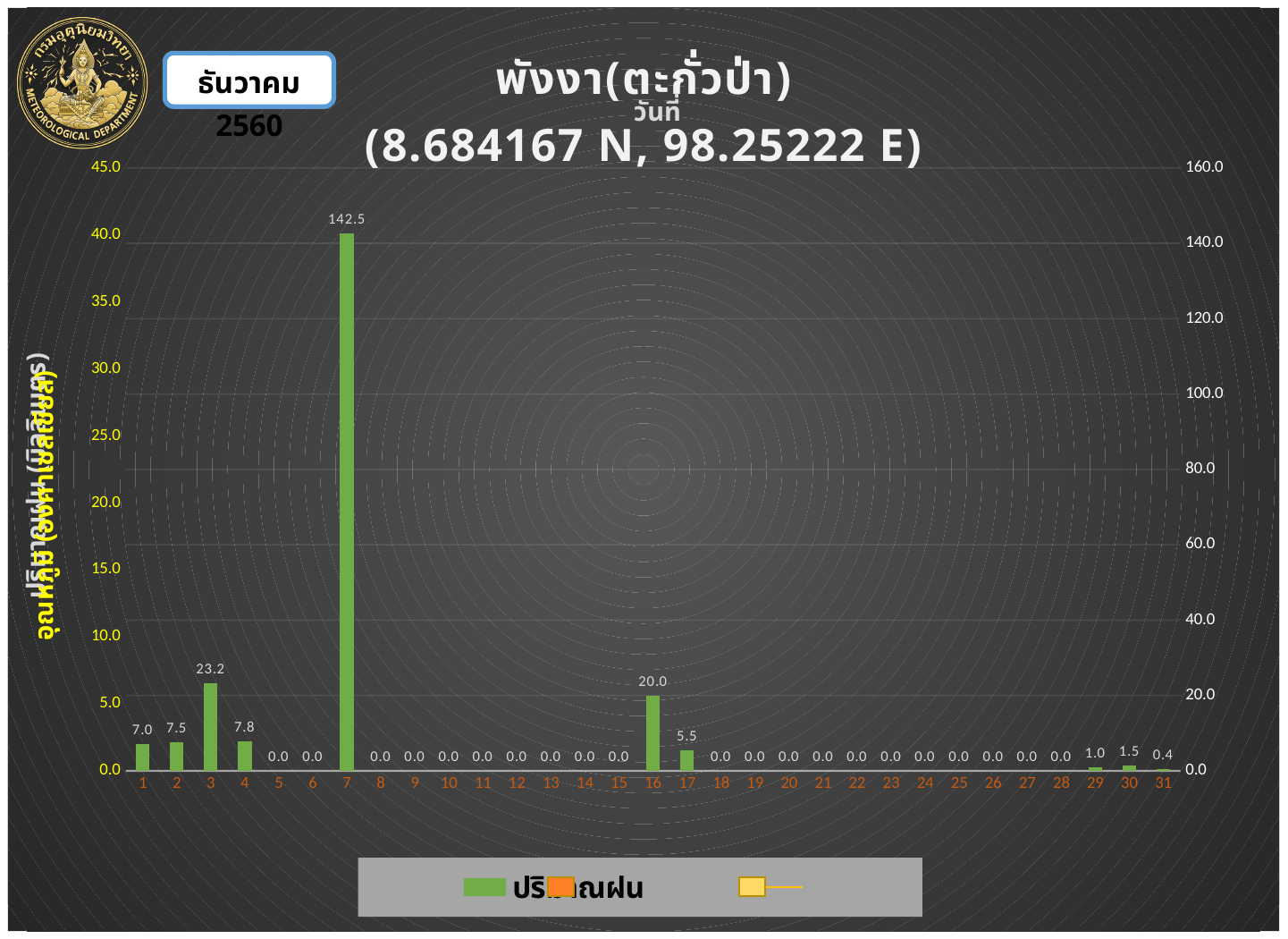
What is the difference between the rainfall values for day 3 and day 16? 3.2 What coordinates are given in the chart title? 8.684167 N, 98.25222 E What is the rainfall value shown for day 3? 23.2 What kind of chart is shown on the slide? bar chart What is the rainfall value shown for day 7? 142.5 How many days (categories) are shown on the x axis? 31 What is the difference between the rainfall values for day 7 and day 16? 122.5 Which day has the highest rainfall value? 7 What is the rainfall value shown for day 16? 20.0 Which day has the larger rainfall value, day 2 or day 4? 4 Which day has the larger rainfall value, day 17 or day 30? 17 What is the rainfall value shown for day 31? 0.4